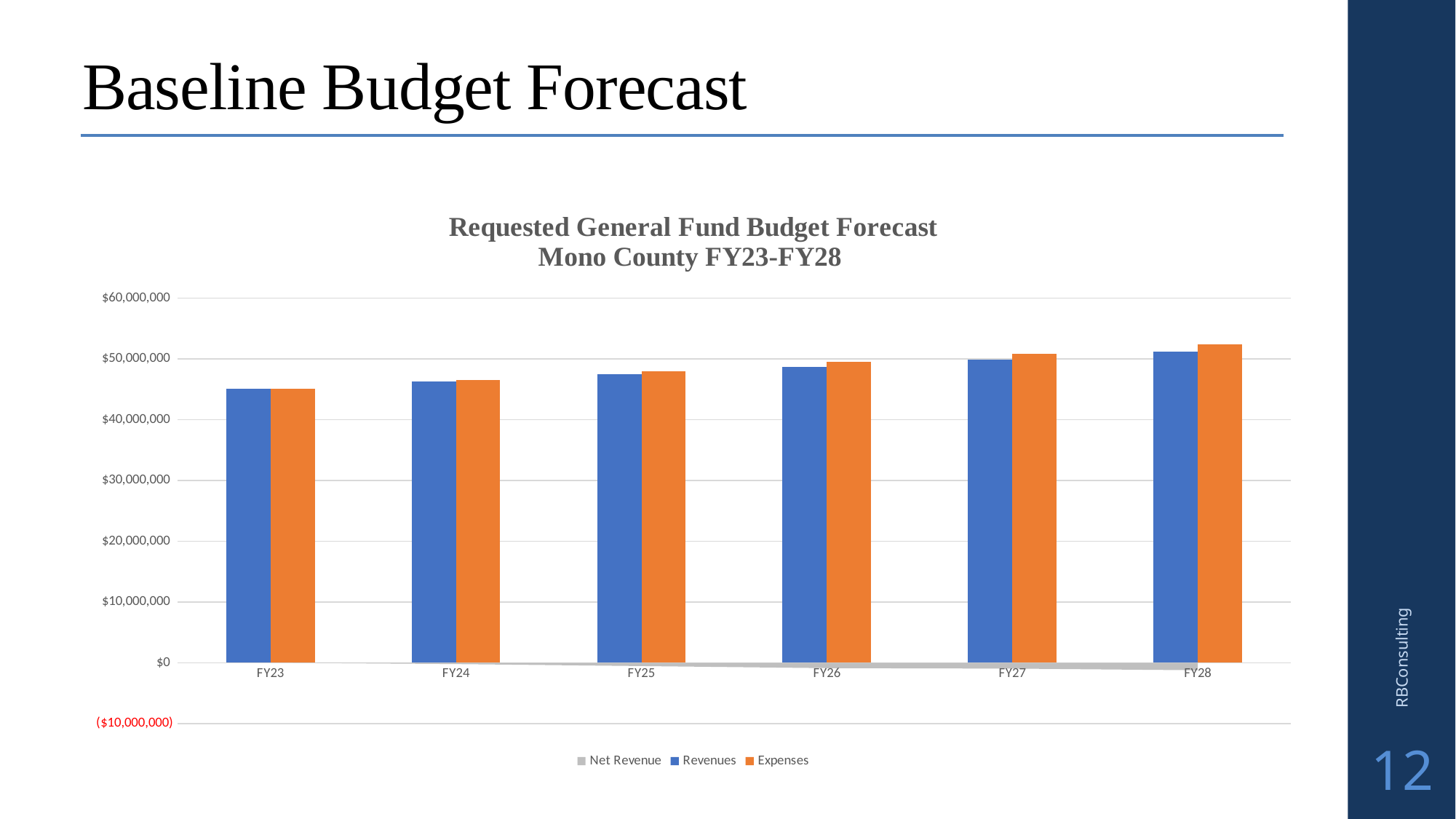
Do Revenues rise or fall from FY23 to FY28? rise How many series does the chart legend list? 3 Is the Expenses value for FY23 greater or less than $40,000,000? greater Which is larger, Revenues in FY28 or Revenues in FY23? Revenues in FY28 Which fiscal year has the highest Revenues bar? FY28 What is the title of the chart? Requested General Fund Budget Forecast Mono County FY23-FY28 How many fiscal years are shown on the x axis of the chart? 6 Is the Revenues value for FY23 greater or less than $50,000,000? less What kind of chart is shown on the slide? bar chart Which fiscal year has the lowest Expenses bar? FY23 Is the Expenses value for FY28 greater or less than $50,000,000? greater Which series is shown in orange in the chart legend? Expenses